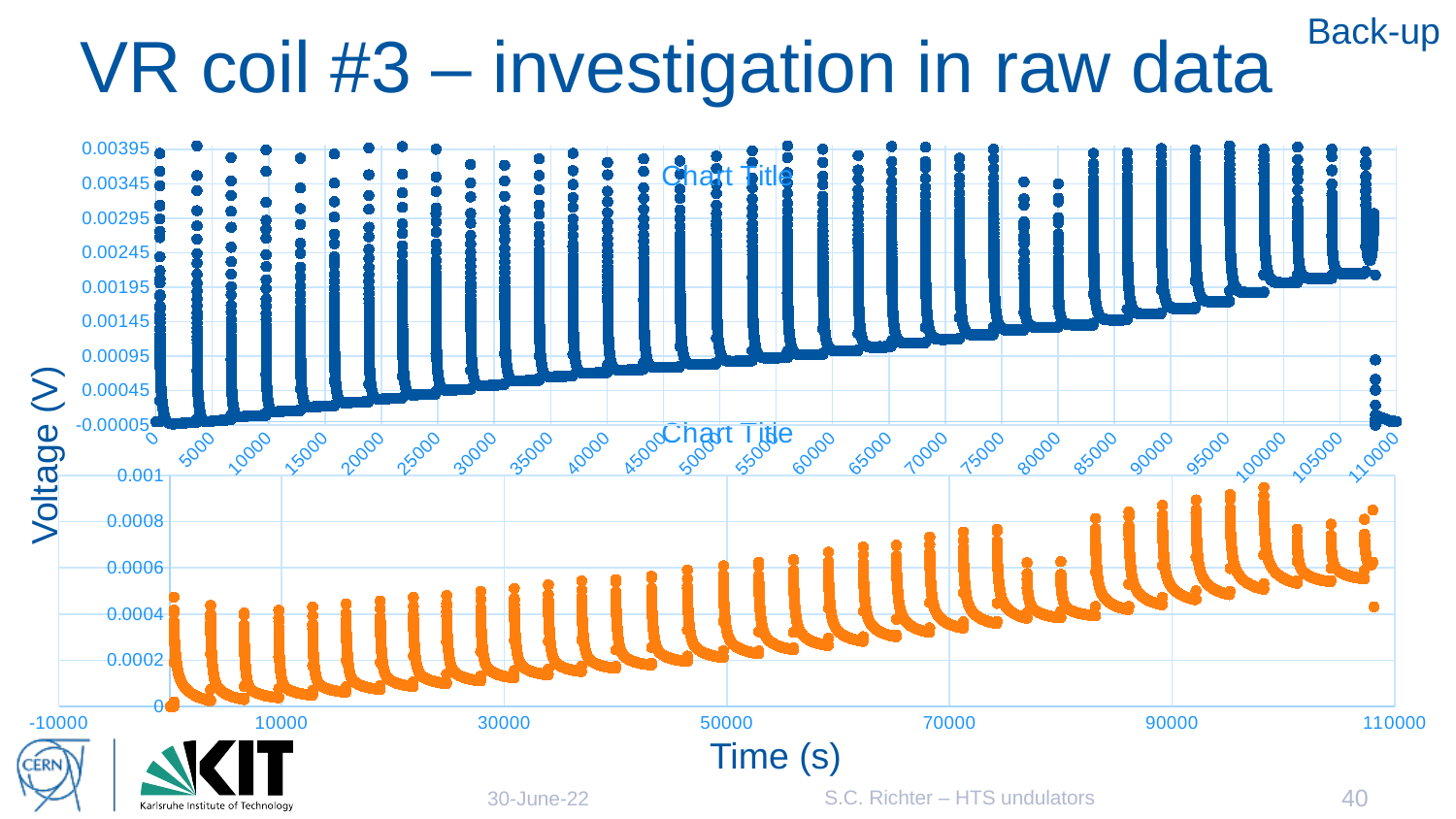
In the top chart, is the lowest value of the spike near 100000 s greater or less than 0.00145? greater In the top chart, do the lowest points of the spikes rise or fall as time increases along the x axis? rise In the bottom chart, is the peak value of the spike near 95000 s greater or less than 0.0008? greater What is the highest tick value shown on the y axis of the bottom chart? 0.001 What kind of chart is the top chart on the slide? scatter chart In the bottom chart, is the lowest value of the first spike (near 0 s) greater or less than 0.0002? less In the bottom chart, do the lowest points of the spikes rise or fall as time increases along the x axis? rise What colour are the data points in the bottom chart? orange What kind of chart is the bottom chart on the slide? scatter chart What colour are the data points in the top chart? blue